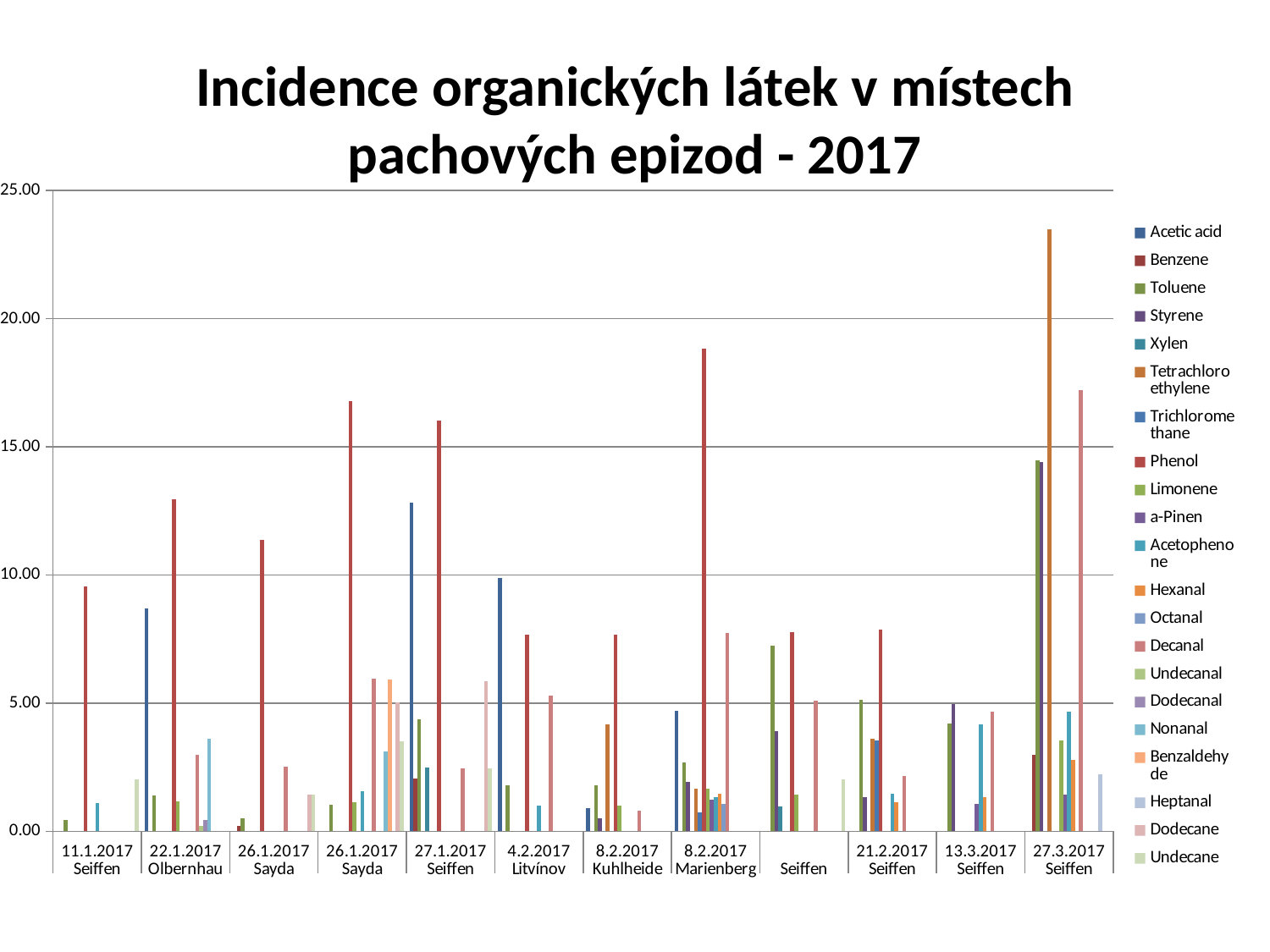
What kind of chart is shown on the slide? bar chart What is the title of the chart? Incidence organických látek v místech pachových epizod - 2017 Which series has the tallest bar in the whole chart? Tetrachloroethylene What is the highest value shown on the vertical axis? 25.00 Is the value for Phenol at 11.1.2017 Seiffen greater or less than 10.00? less How many series does the legend list? 21 Which is larger: the Phenol value at 8.2.2017 Marienberg or the Phenol value at 8.2.2017 Kuhlheide? 8.2.2017 Marienberg Is the value for Phenol at 8.2.2017 Marienberg greater or less than 15.00? greater How many categories (sampling events) are shown along the x axis? 12 In which category does the tallest bar of the chart appear? 27.3.2017 Seiffen Is the value for Tetrachloroethylene at 27.3.2017 Seiffen greater or less than 20.00? greater